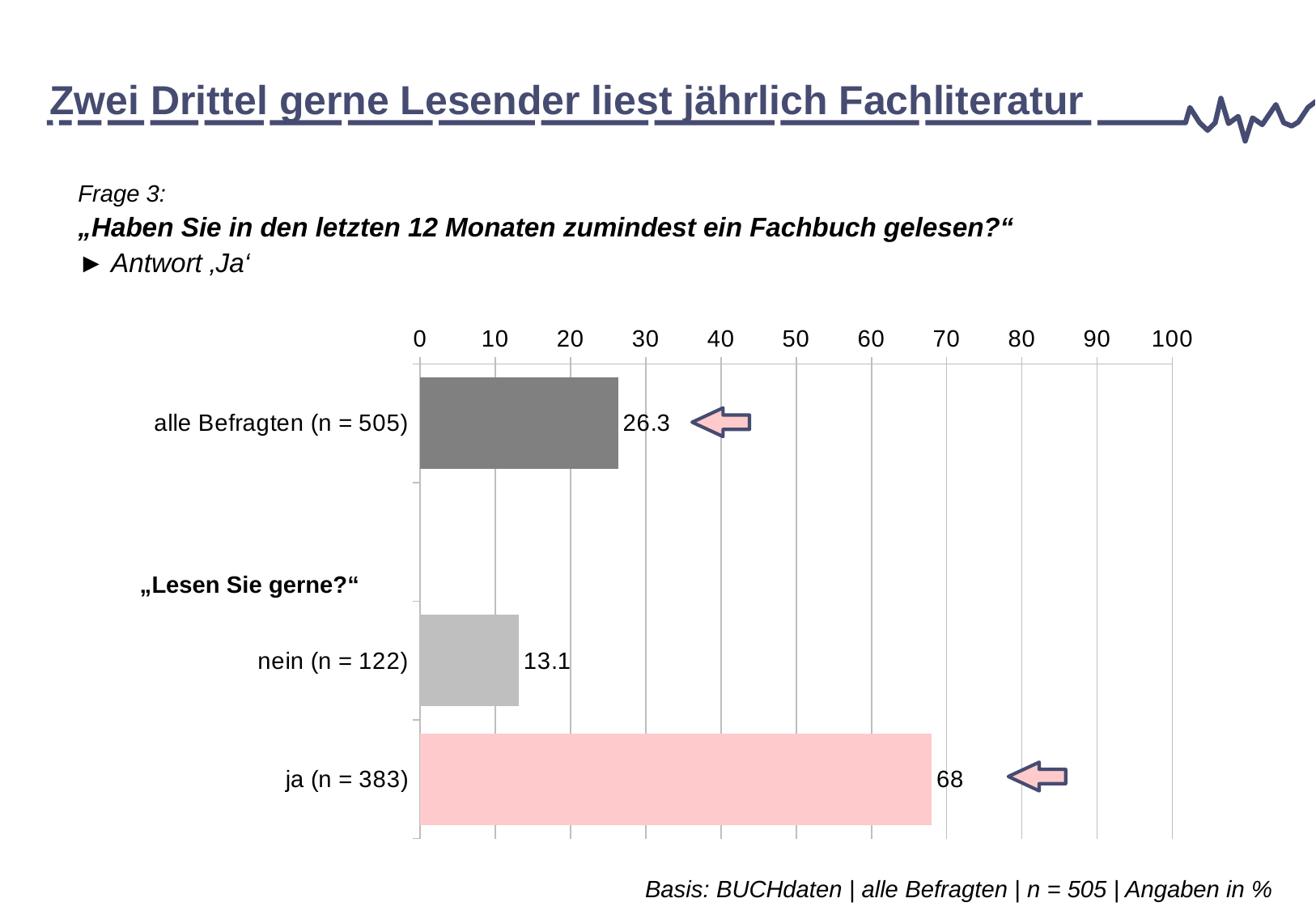
What is the difference between the values for "ja (n = 383)" and "nein (n = 122)"? 54.9 What is the value for "alle Befragten (n = 505)"? 26.3 What is the difference between the values for "alle Befragten (n = 505)" and "nein (n = 122)"? 13.2 Which category has the highest value? ja (n = 383) What kind of chart is shown on the slide? bar chart Which category has the lowest value? nein (n = 122) Is the value for "ja (n = 383)" greater or less than 60? greater How many bars are plotted in the chart? 3 What is the value for "nein (n = 122)"? 13.1 What is the value for "ja (n = 383)"? 68 Which is larger, the value for "ja (n = 383)" or the value for "alle Befragten (n = 505)"? ja (n = 383) What is the maximum value shown on the chart's axis? 100